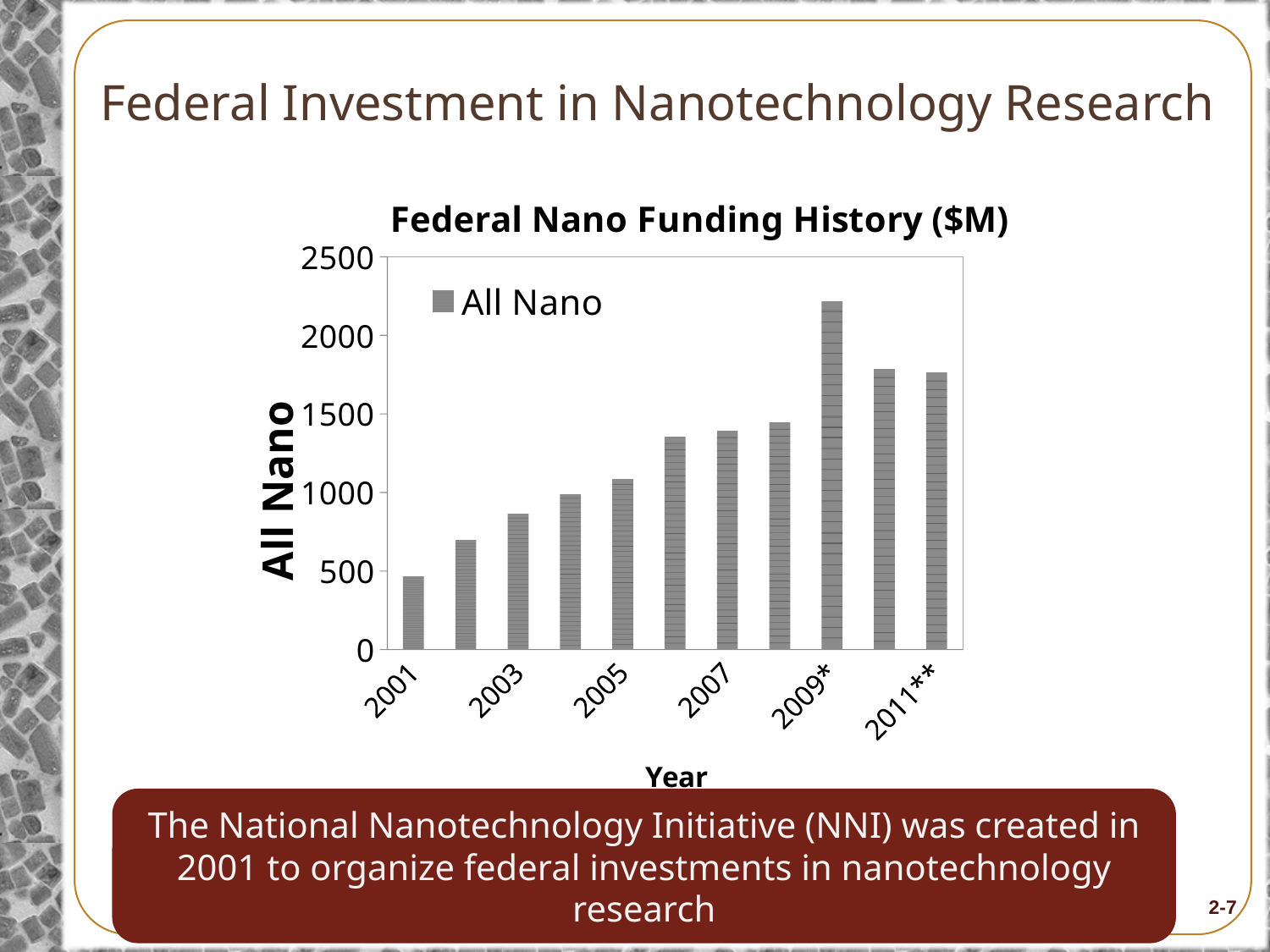
Is the value for 2001 greater or less than 500? less Is the value for 2009* greater or less than 2000? greater What is the name of the series shown in the legend? All Nano What is the title of the chart? Federal Nano Funding History ($M) Which year has the highest All Nano funding value? 2009* How many bars are plotted in the chart? 11 Which year has the lowest All Nano funding value? 2001 Which is larger, the value for 2009* or the value for 2011**? 2009* How many series does the chart legend list? 1 Do the values rise or fall from 2001 to 2009*? rise What kind of chart is shown on the slide? bar chart Is the value for 2005 greater or less than 1000? greater